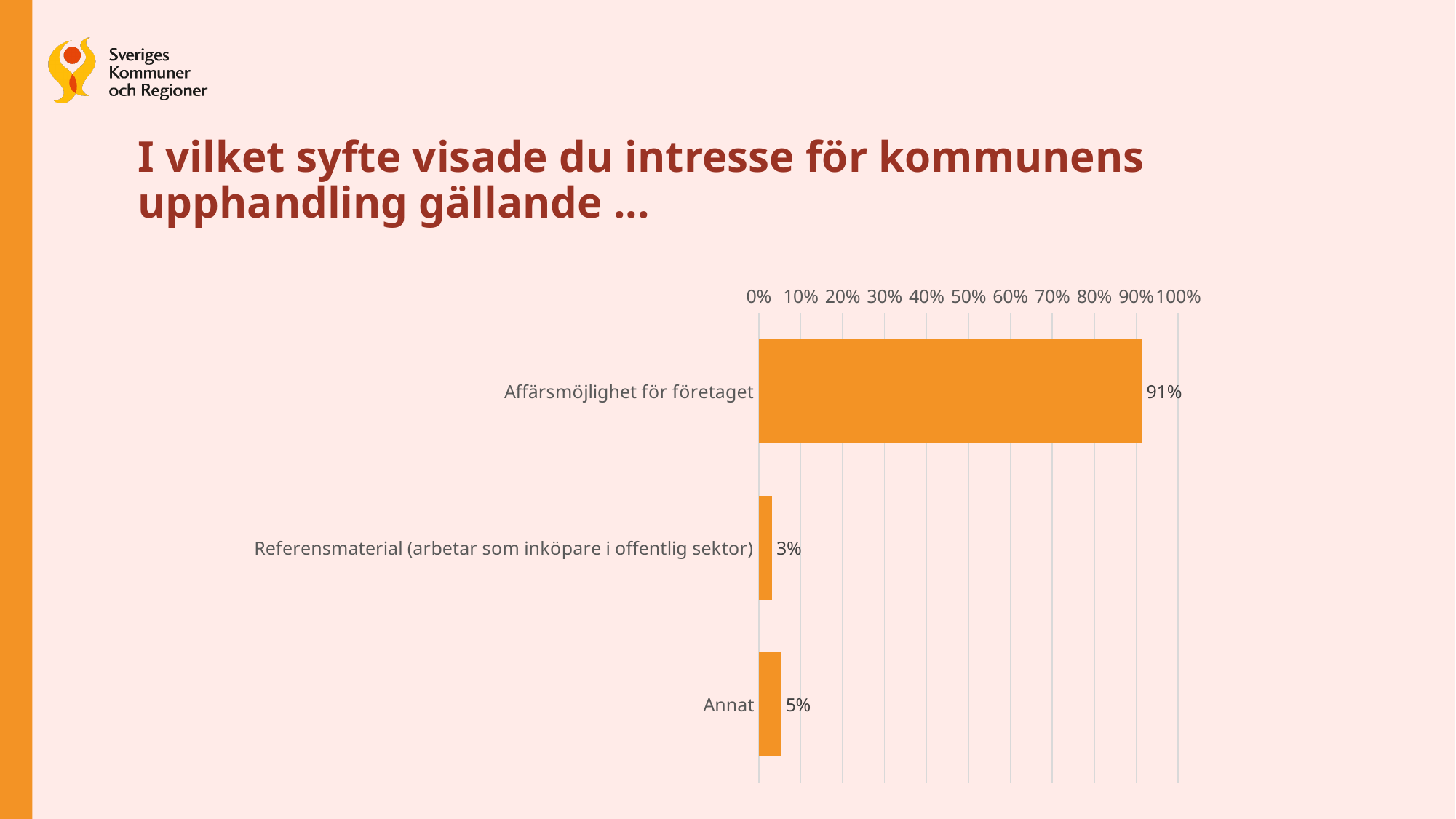
How many categories are shown in the chart? 3 What is the difference between the values for Affärsmöjlighet för företaget and Annat? 86% What kind of chart is shown on the slide? bar chart Is the value for Affärsmöjlighet för företaget greater or less than 50%? greater What is the value for Affärsmöjlighet för företaget? 91% Which is larger, the value for Annat or the value for Referensmaterial (arbetar som inköpare i offentlig sektor)? Annat What is the highest value shown on the chart's axis? 100% Which category has the highest value? Affärsmöjlighet för företaget What is the value for Referensmaterial (arbetar som inköpare i offentlig sektor)? 3% What is the difference between the values for Annat and Referensmaterial (arbetar som inköpare i offentlig sektor)? 2% What is the value for Annat? 5% Which category has the lowest value? Referensmaterial (arbetar som inköpare i offentlig sektor)